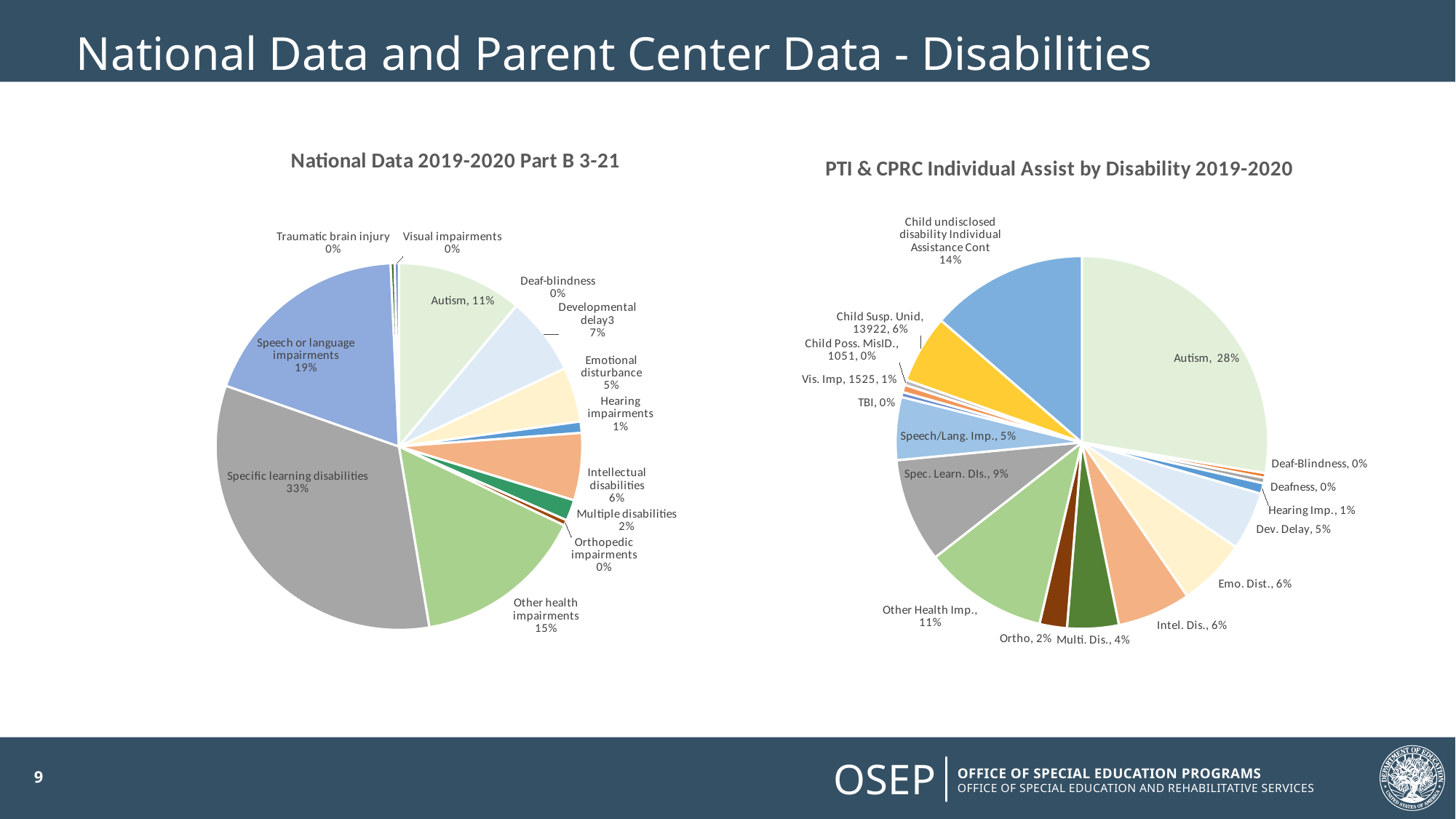
In the 'National Data 2019-2020 Part B 3-21' chart, what is the difference in percentage points between Other health impairments and Autism? 4 In the 'National Data 2019-2020 Part B 3-21' chart, what share is Speech or language impairments? 19% What is the title of the pie chart on the right side of the slide? PTI & CPRC Individual Assist by Disability 2019-2020 In the 'National Data 2019-2020 Part B 3-21' chart, what share is Specific learning disabilities? 33% In the 'PTI & CPRC Individual Assist by Disability 2019-2020' chart, what is the difference in percentage points between Other Health Imp. and Spec. Learn. Dis.? 2 In the 'National Data 2019-2020 Part B 3-21' chart, which category has the largest share? Specific learning disabilities In the 'PTI & CPRC Individual Assist by Disability 2019-2020' chart, which category has the largest share? Autism In the 'PTI & CPRC Individual Assist by Disability 2019-2020' chart, what share is Child undisclosed disability Individual Assistance Cont? 14% What type of chart is the 'National Data 2019-2020 Part B 3-21' chart? Pie chart How many categories are shown in the 'National Data 2019-2020 Part B 3-21' pie chart? 13 In the 'National Data 2019-2020 Part B 3-21' chart, which is larger: Emotional disturbance or Intellectual disabilities? Intellectual disabilities